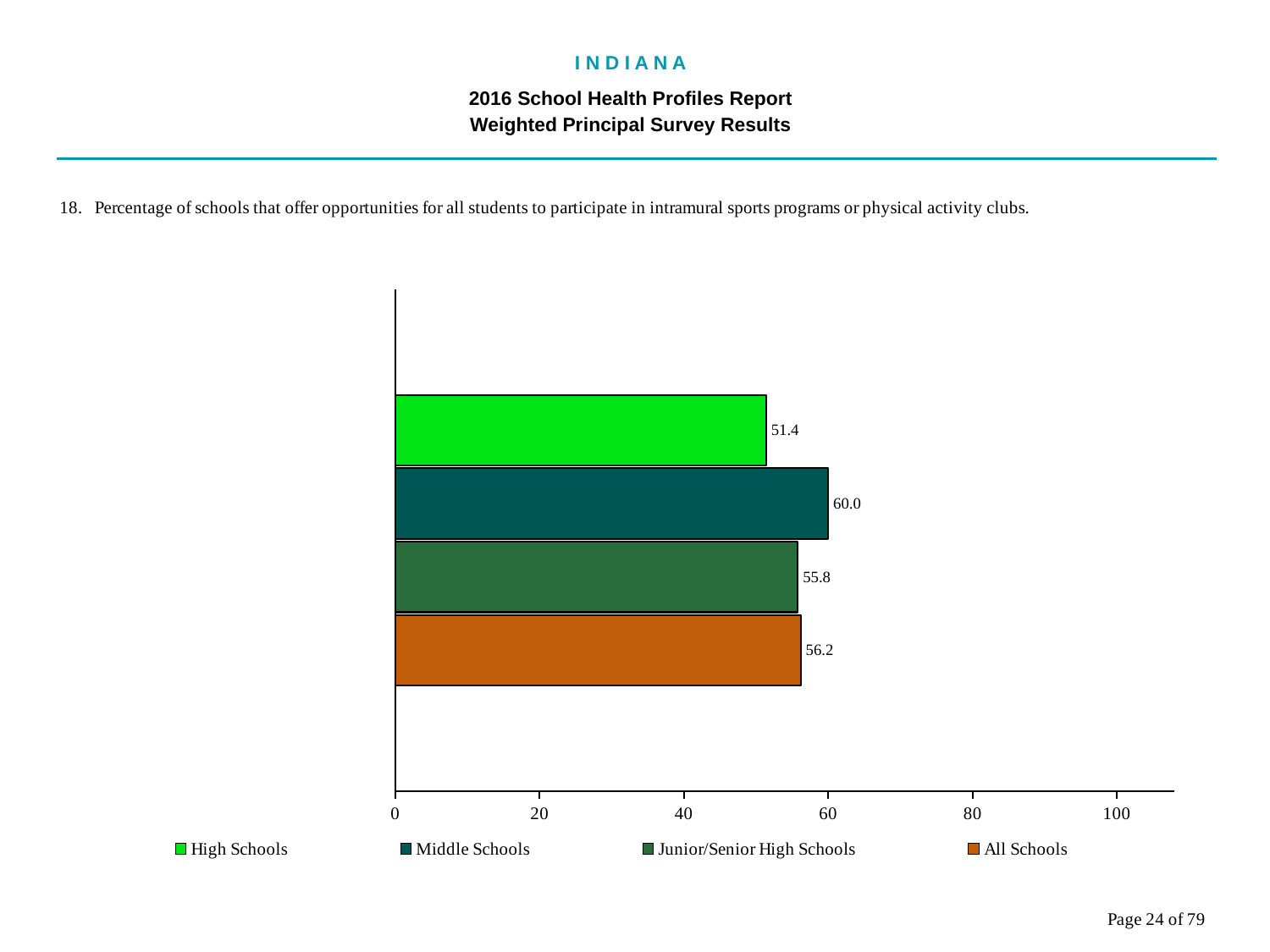
What is the value for All Schools? 56.2 What kind of chart is shown on the slide? bar chart How many series does the legend list? 4 Is the value for High Schools greater or less than 60? less Which is larger, the value for Middle Schools or the value for All Schools? Middle Schools What is the value for High Schools? 51.4 What is the value for Middle Schools? 60.0 Which school type has the highest value? Middle Schools Which school type has the lowest value? High Schools What is the difference between the Middle Schools value and the High Schools value? 8.6 What colour is the bar for All Schools? orange What is the value for Junior/Senior High Schools? 55.8